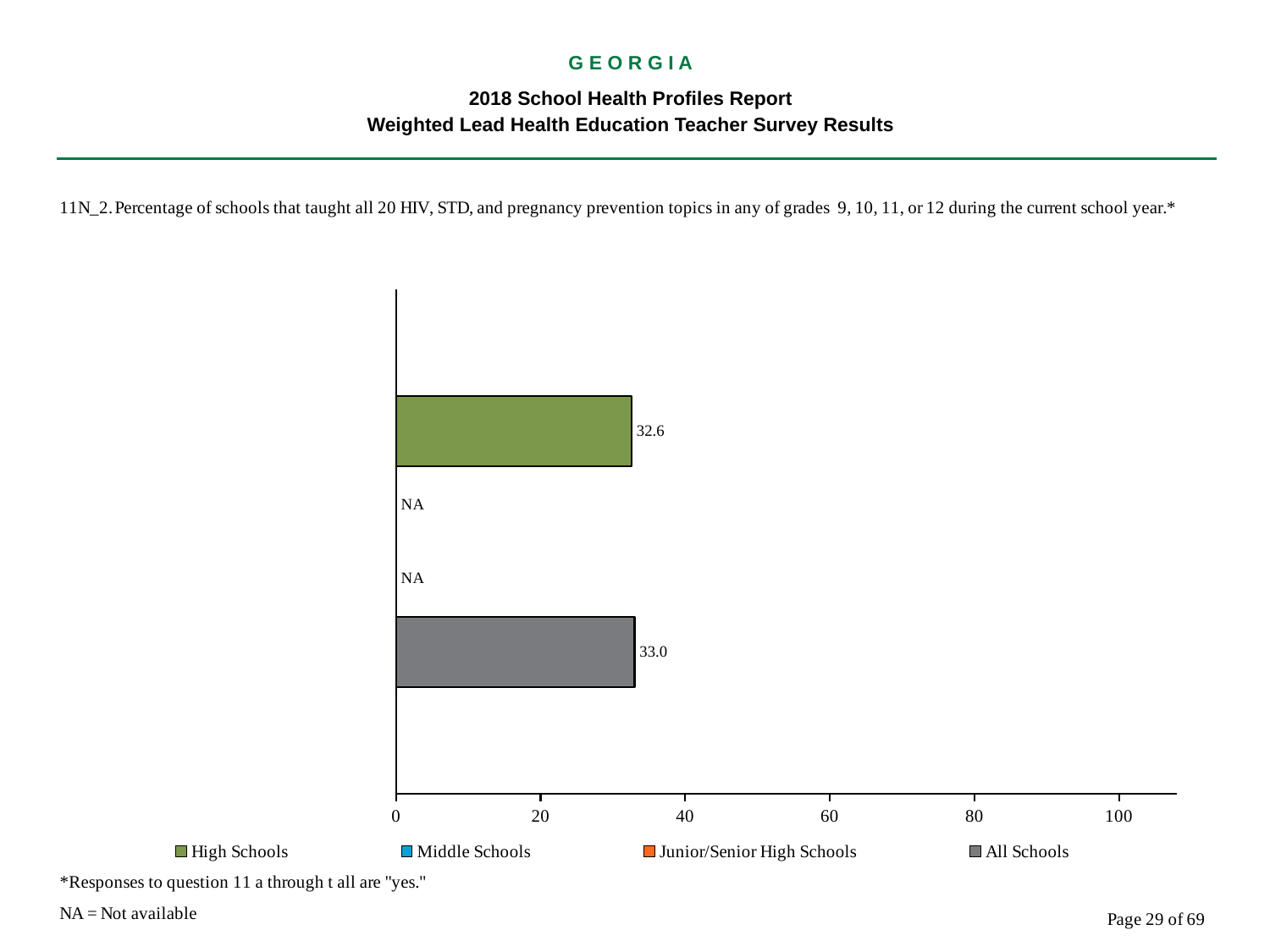
Is the value for All Schools greater or less than 20? greater Is the value for High Schools greater or less than 40? less What does NA stand for according to the slide? Not available What kind of chart is shown on the slide? bar chart What is the value for All Schools? 33.0 What is the value for High Schools? 32.6 What is the difference between the All Schools value and the High Schools value? 0.4 How many categories have a plotted bar with a value? 2 What colour is the bar for All Schools? gray What is shown for Middle Schools? NA What is shown for Junior/Senior High Schools? NA How many series does the legend list? 4